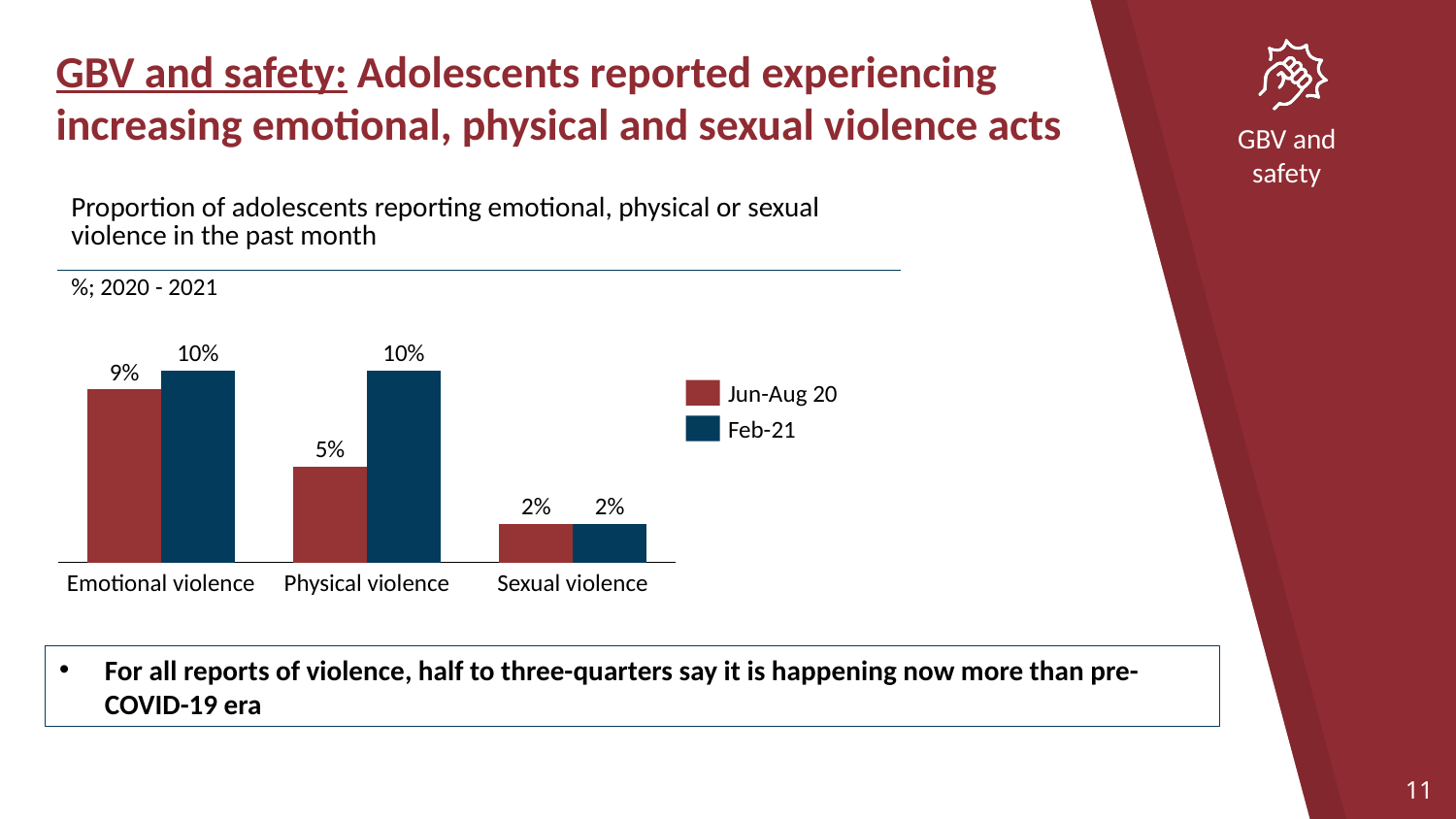
What is the value for Sexual violence in the Jun-Aug 20 series? 2% Which category has the lowest value in the Feb-21 series? Sexual violence How many series does the legend list? 2 Which category has the highest value in the Jun-Aug 20 series? Emotional violence What is the value for Physical violence in the Jun-Aug 20 series? 5% What is the value for Emotional violence in the Jun-Aug 20 series? 9% How many categories are shown on the x axis of the chart? 3 What is the difference between the Feb-21 and Jun-Aug 20 values for Physical violence? 5% What are the two series named in the chart legend? Jun-Aug 20 and Feb-21 What kind of chart is shown on the slide? Bar chart Which is larger for Physical violence: the Jun-Aug 20 value or the Feb-21 value? Feb-21 What is the value for Physical violence in the Feb-21 series? 10%